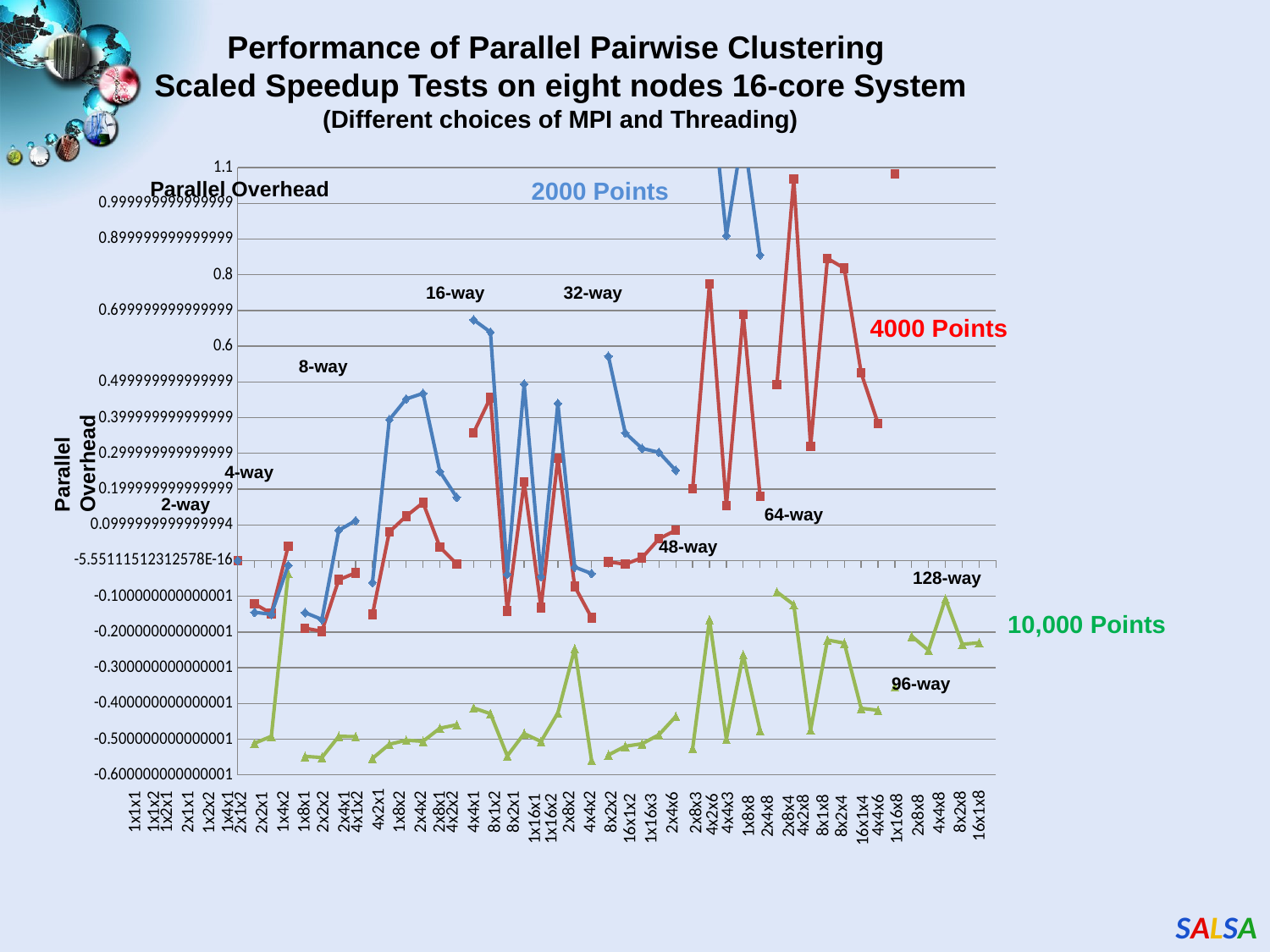
What kind of chart is shown on the slide? line chart What is the title of the y axis of the chart? Parallel Overhead Which series has the lowest values overall on the chart? 10,000 Points Does the 10,000 Points series generally rise or fall from left to right along the x axis? rise What colour is the 10,000 Points series drawn in? green How many data series are plotted on the chart? 3 Is the 4000 Points value at 2x8x4 greater or less than 0.6? less At 4x4x1, which series is higher, 2000 Points or 4000 Points? 2000 Points At 2x8x4, which series is higher, 4000 Points or 10,000 Points? 4000 Points Is the 10,000 Points value at 1x16x8 greater or less than 0.6? less Is the 2000 Points value at 4x4x1 greater or less than 0.8? less